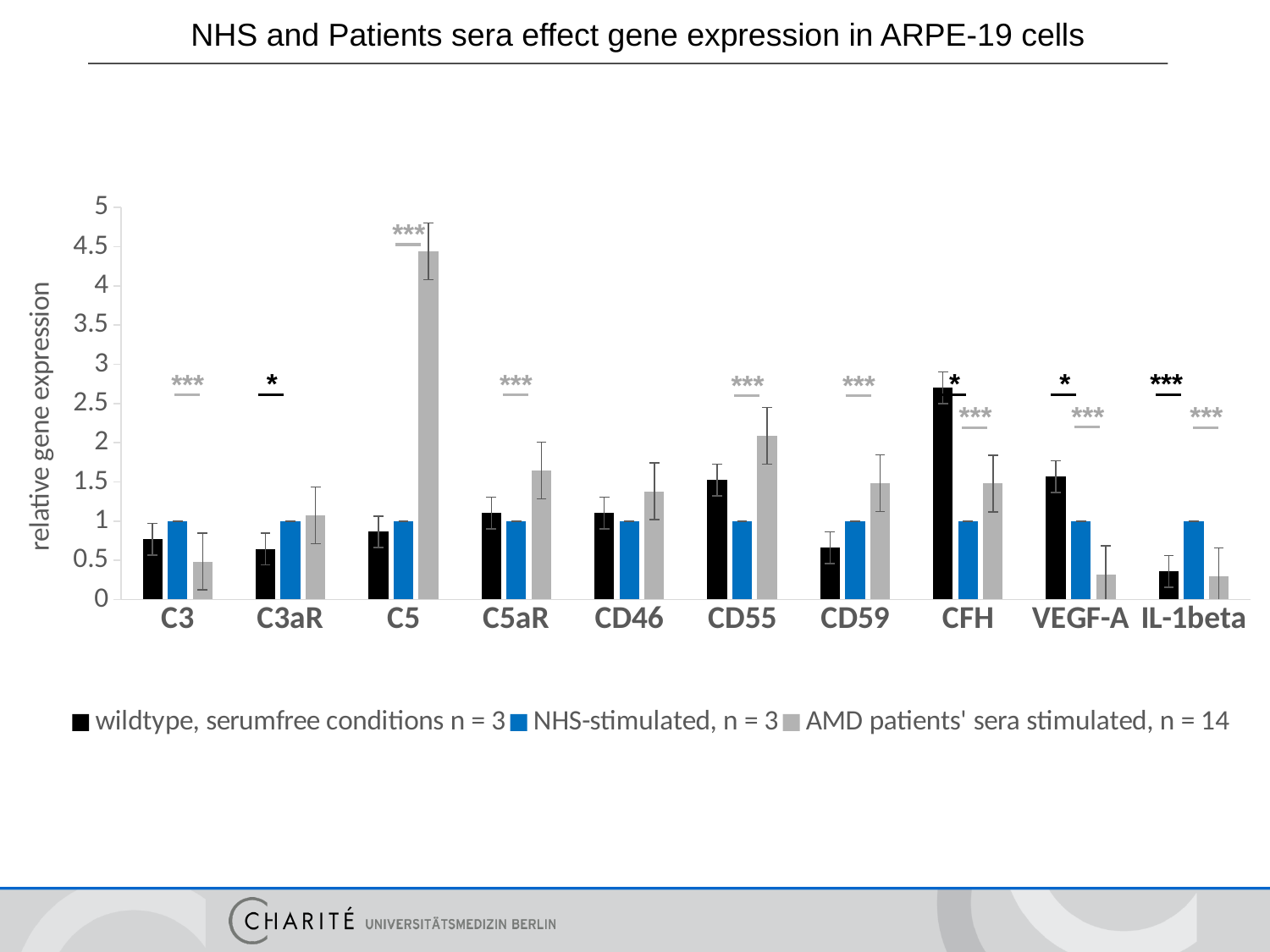
Which gene has the lowest value for the wildtype, serumfree conditions series? IL-1beta What kind of chart is shown on the slide? bar chart How many gene categories are shown on the x axis? 10 What is the label of the y axis? relative gene expression Which gene has the highest value for the AMD patients' sera stimulated series? C5 Is the AMD patients' sera stimulated value for C5 greater or less than 4? greater Is the AMD patients' sera stimulated value for IL-1beta greater or less than 0.5? less What is the NHS-stimulated value for C3? 1 Is the wildtype, serumfree conditions value for CFH greater or less than 2? greater For CD55, which is larger: the wildtype, serumfree conditions value or the AMD patients' sera stimulated value? AMD patients' sera stimulated How many series does the legend list? 3 For CFH, which is larger: the wildtype, serumfree conditions value or the AMD patients' sera stimulated value? wildtype, serumfree conditions